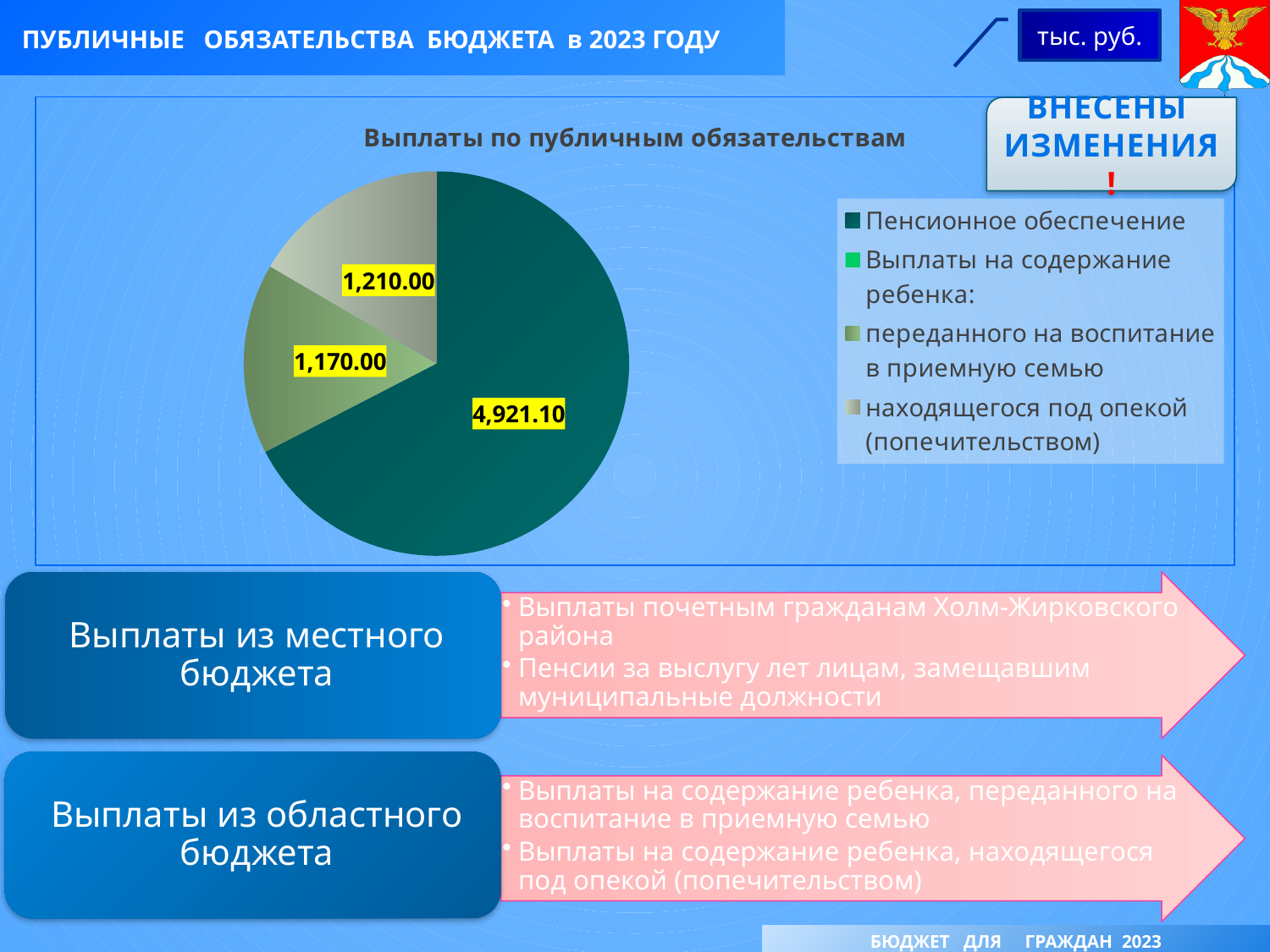
How many slices with data labels are shown in the pie chart? 3 What is the value of the slice for Пенсионное обеспечение? 4,921.10 What is the difference between the Пенсионное обеспечение slice and the slice for the child under guardianship (попечительством)? 3,711.10 What is the value of the slice for the child transferred to a foster family (переданного на воспитание в приемную семью)? 1,170.00 What type of chart is shown on the slide? pie chart What is the title of the chart? Выплаты по публичным обязательствам Which is larger: the slice for the child under guardianship (попечительством) or the slice for the child in a foster family (приемную семью)? находящегося под опекой (попечительством) Which category has the largest slice in the pie chart? Пенсионное обеспечение How many entries does the chart legend list? 4 Which category has the smallest slice in the pie chart? переданного на воспитание в приемную семью What is the difference between the slice for the child under guardianship and the slice for the child in a foster family? 40.00 What is the value of the slice for the child under guardianship (находящегося под опекой (попечительством))? 1,210.00